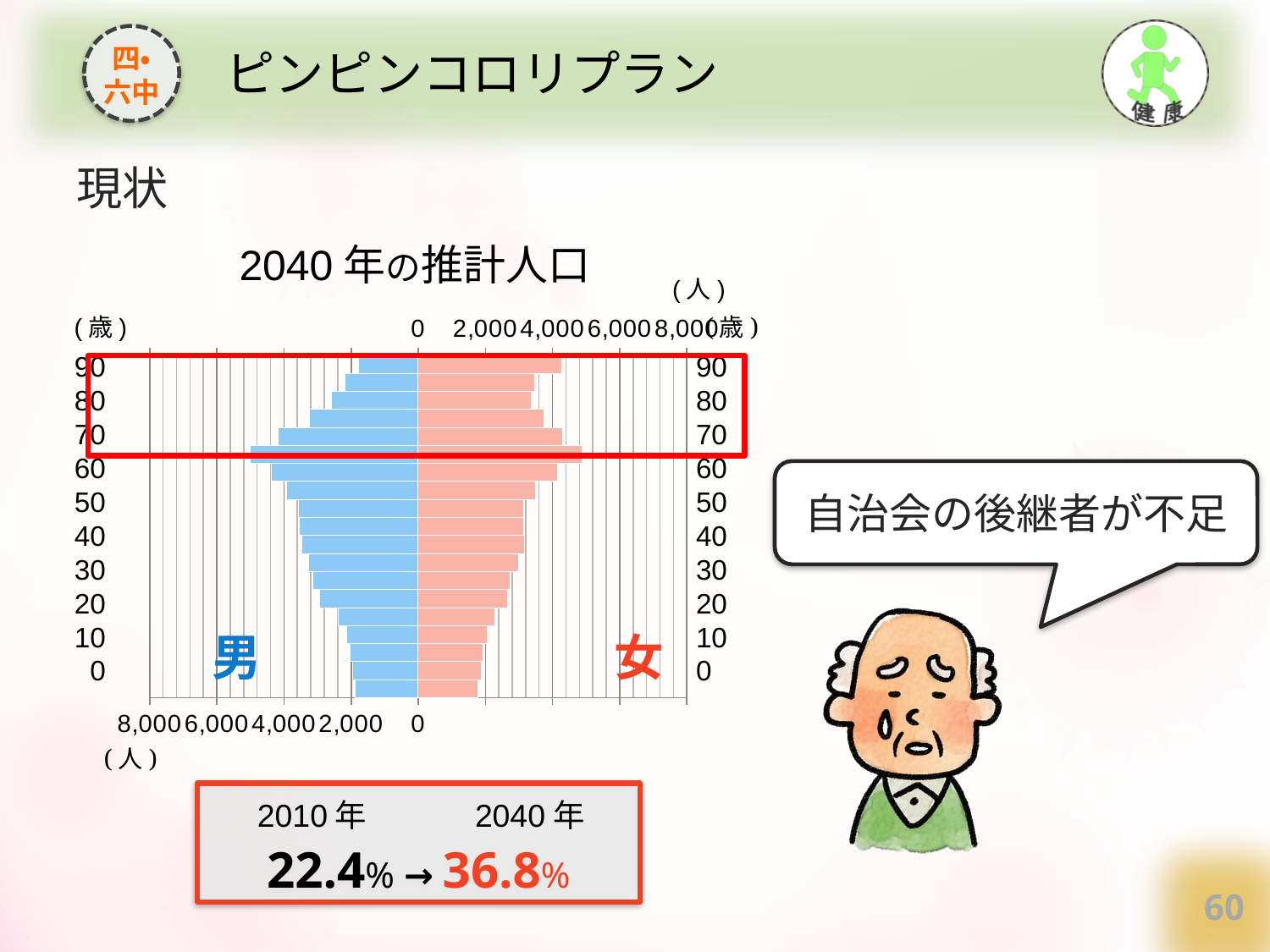
Is the value for the female (女) bar at age 50 greater or less than 6,000? less Is the value for the longest male (男) bar, in the 65–69 age group, greater or less than 4,000? greater Going from age 0 up to the late 60s, do the male (男) bars generally get longer or shorter? longer Is the value for the female (女) bar at age 90 greater or less than 2,000? greater How many series (sexes) does the chart show? 2 At age 90, which is larger, the male (男) bar or the female (女) bar? female (女) Which colour represents 男 (male) in the chart? blue Which is larger, the male (男) bar at age 0 or the male (男) bar in the 65–69 age group? the 65–69 age group What kind of chart is shown on the slide? bar chart What is the title of the chart? 2040年の推計人口